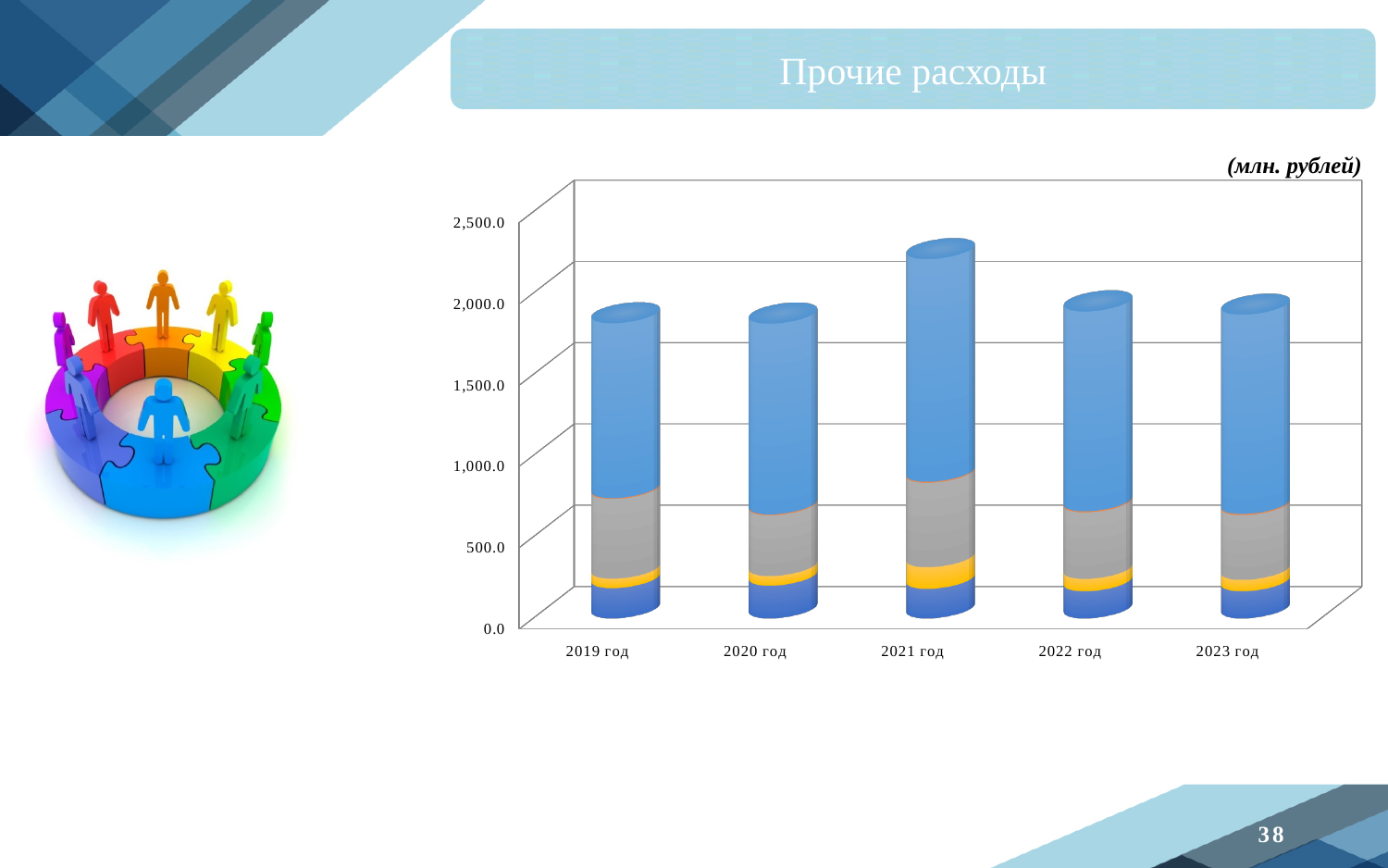
Does the total value rise or fall from 2021 год to 2022 год? fall Is the total value for 2021 год greater or less than 2,500.0? less Is the total value for 2021 год greater or less than 2,000.0? greater How many years (categories) are shown on the x axis of the chart? 5 Is the total value for 2019 год greater or less than 2,500.0? less What kind of chart is shown on the slide? Stacked bar chart Does the total value rise or fall from 2020 год to 2021 год? rise In what units are the values on the chart expressed? млн. рублей What is the title of the chart on the slide? Прочие расходы Which year has the highest total bar on the chart? 2021 год Which is larger, the total for 2021 год or the total for 2020 год? 2021 год